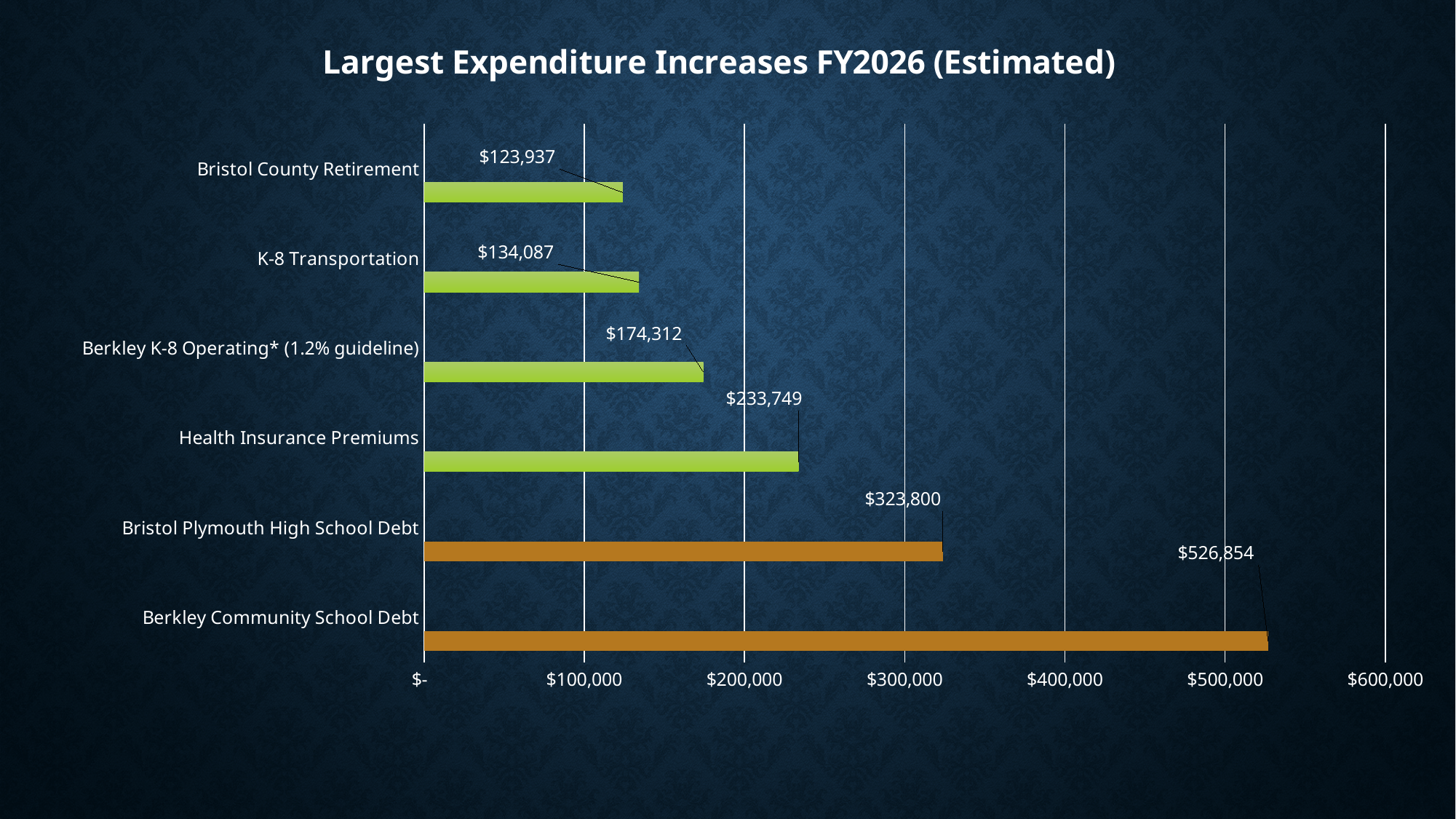
Which category has the largest expenditure increase? Berkley Community School Debt What type of chart is shown on the slide? Bar chart What is the value for Health Insurance Premiums? $233,749 Which is larger, Bristol Plymouth High School Debt or Health Insurance Premiums? Bristol Plymouth High School Debt What is the value for K-8 Transportation? $134,087 What is the difference between Berkley Community School Debt and Bristol Plymouth High School Debt? $203,054 Which category has the smallest expenditure increase? Bristol County Retirement What is the value for Berkley K-8 Operating* (1.2% guideline)? $174,312 What is the value for Berkley Community School Debt? $526,854 What is the difference between Health Insurance Premiums and Berkley K-8 Operating* (1.2% guideline)? $59,437 Is the value for Bristol Plymouth High School Debt greater or less than $300,000? greater How many categories are shown in the chart? 6